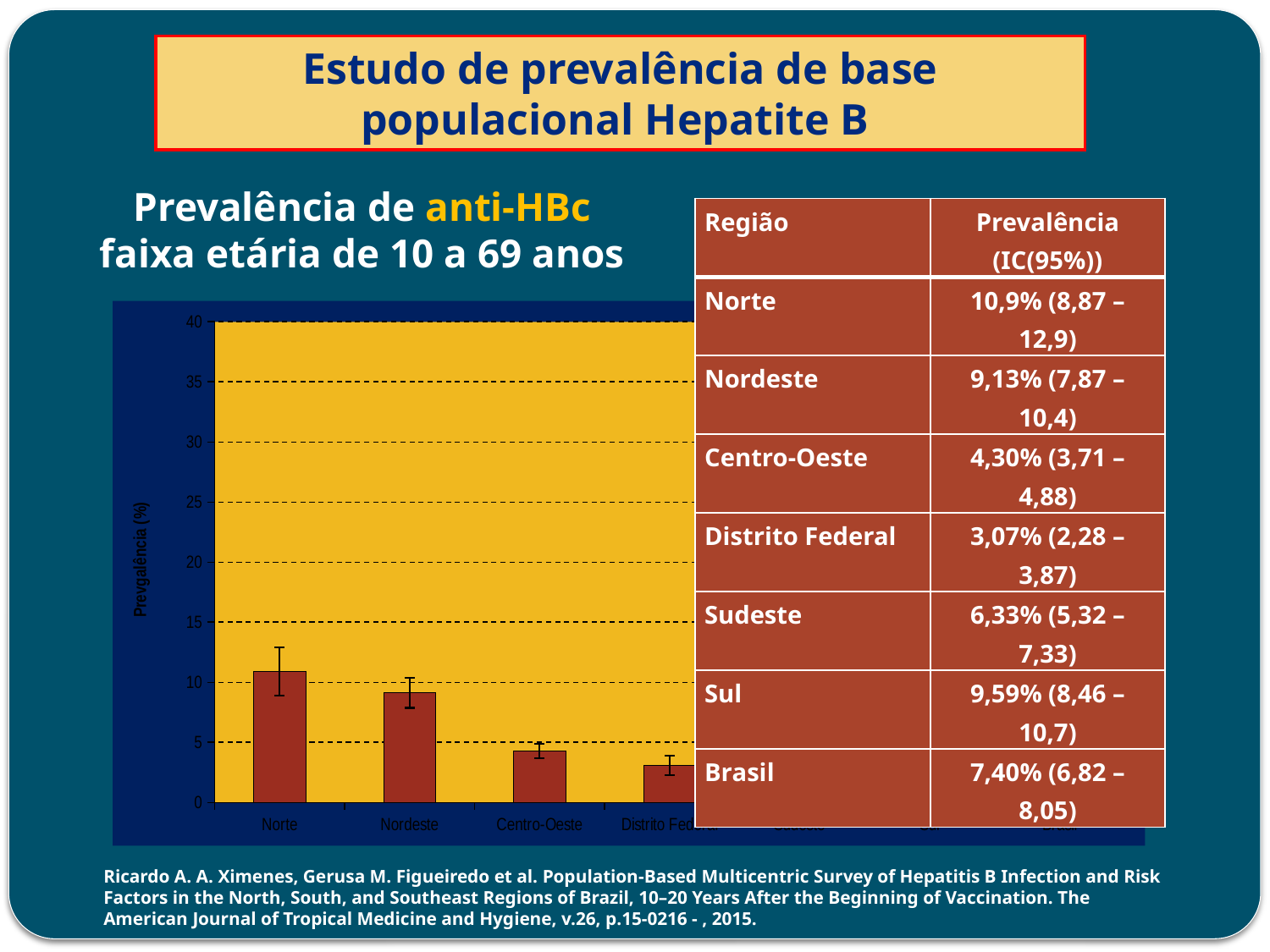
Is the bar for Norte greater or less than 15? less Among the bars visible on the chart, which region has the tallest bar? Norte Which bar is taller, Centro-Oeste or Distrito Federal? Centro-Oeste Is the bar for Distrito Federal greater or less than 5? less Among the bars visible on the chart, which region has the shortest bar? Distrito Federal What is the label of the y axis of the chart? Prevgalência (%) Is the bar for Nordeste greater or less than 5? greater Which bar is taller, Norte or Nordeste? Norte What is the highest value shown on the y axis of the chart? 40 According to the table on the slide, what is the anti-HBc prevalence for Norte? 10,9% Do the bars rise or fall going from Norte to Distrito Federal along the x axis? fall What kind of chart is shown on the slide? bar chart